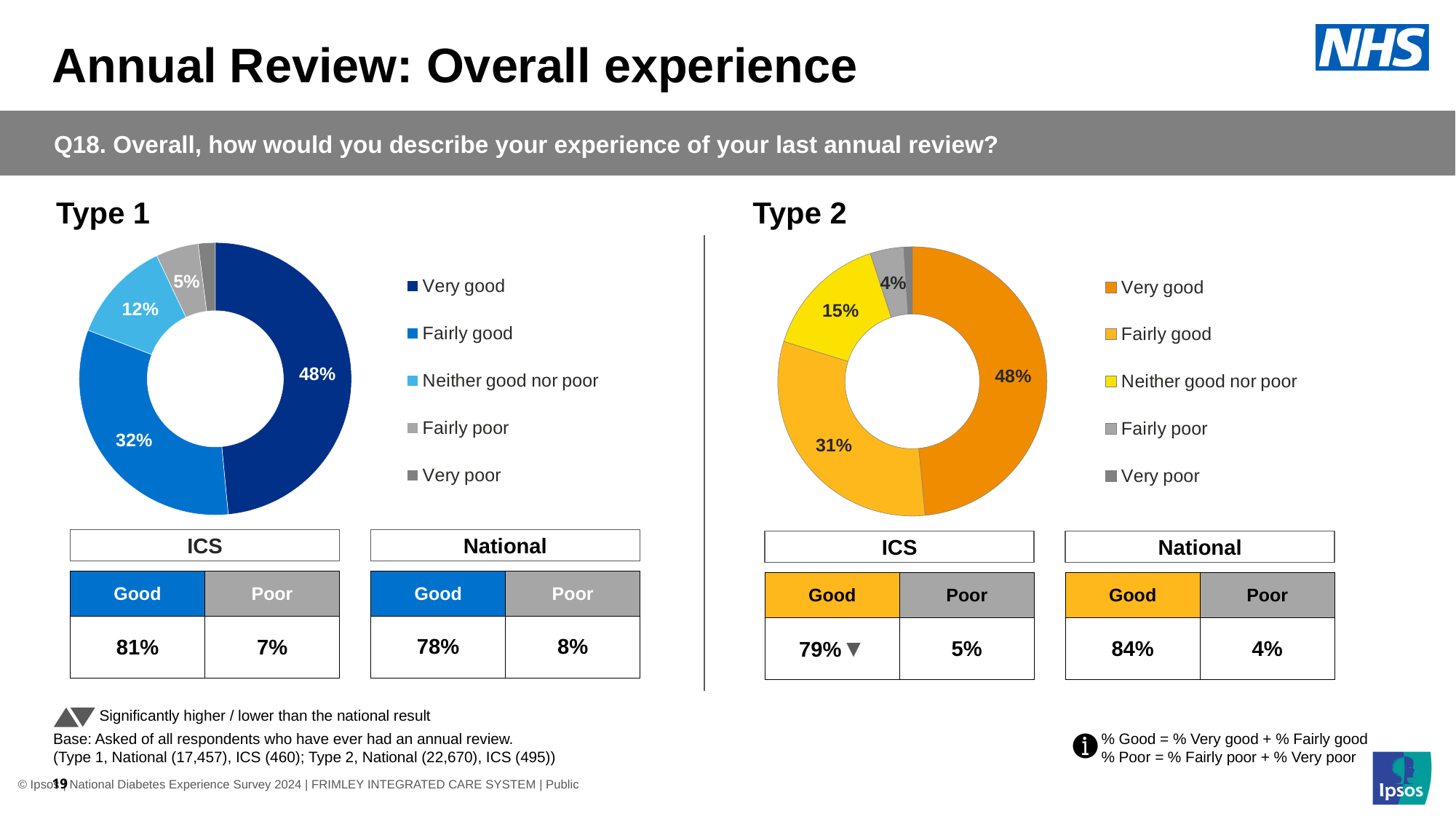
In the Type 1 chart, what percentage said Neither good nor poor? 12% In the Type 2 chart, what percentage said Neither good nor poor? 15% In the Type 1 chart, what percentage said Fairly good? 32% What kind of chart is used for Type 1 and Type 2? Donut (pie) chart In the Type 2 chart, what percentage said Fairly poor? 4% In the Type 2 chart, what percentage said Fairly good? 31% In the Type 1 chart, what percentage of respondents said their experience was Very good? 48% Which chart has the larger Neither good nor poor share, Type 1 or Type 2? Type 2 In the Type 1 chart, what is the difference between the Very good and Fairly good shares? 16 percentage points How many response categories does the legend of the Type 2 chart list? 5 In the Type 1 chart, which response category has the largest share? Very good In the Type 2 chart, which response category has the smallest share? Very poor